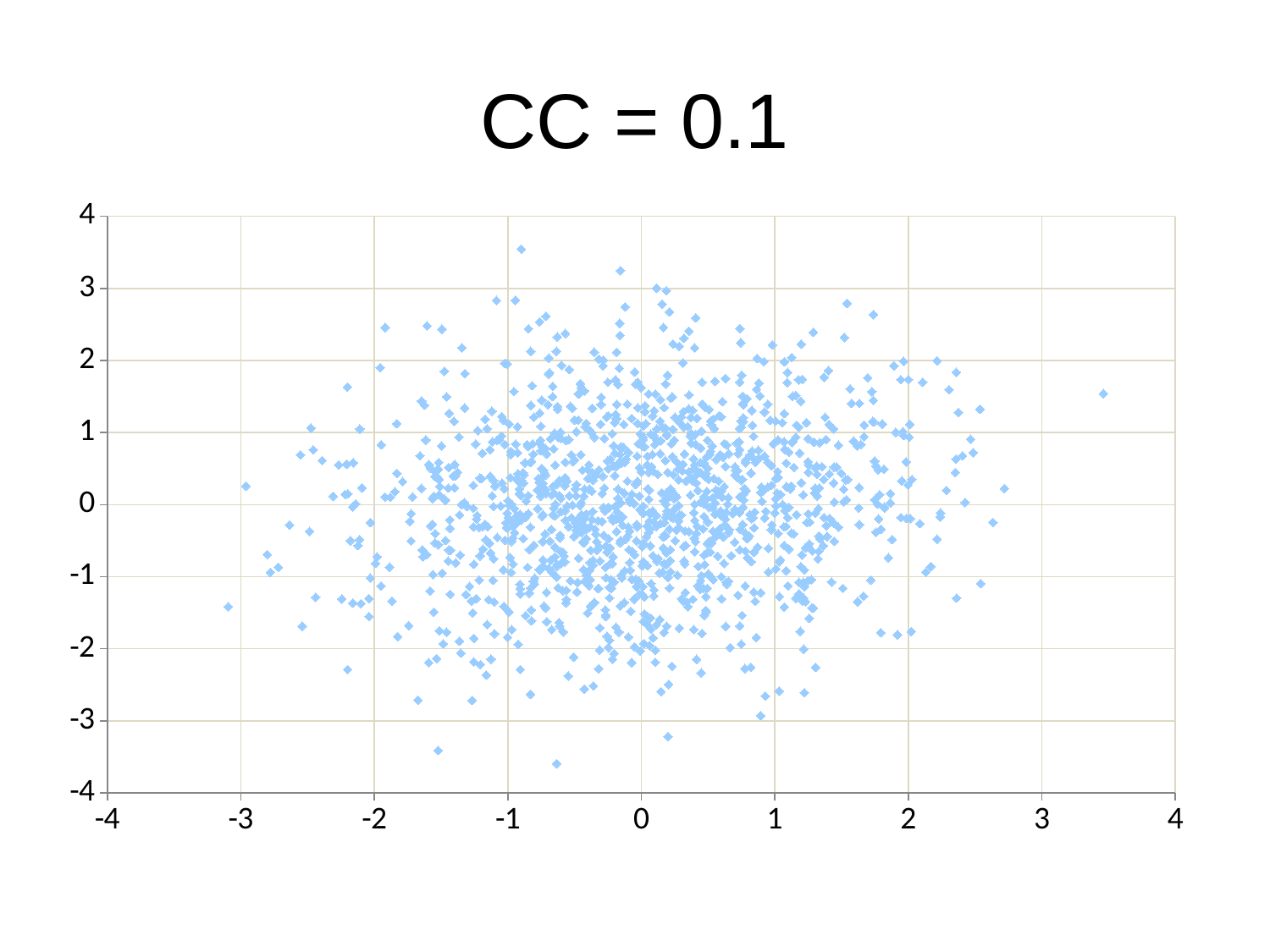
What are the lowest and highest values shown on the x axis? -4 and 4 Is the x value of the highest point greater or less than 0? less Is the y value of the lowest point greater or less than -3? less What kind of chart is shown on the slide? scatter plot Is the y value of the highest point greater or less than 3? greater What is the title of the chart? CC = 0.1